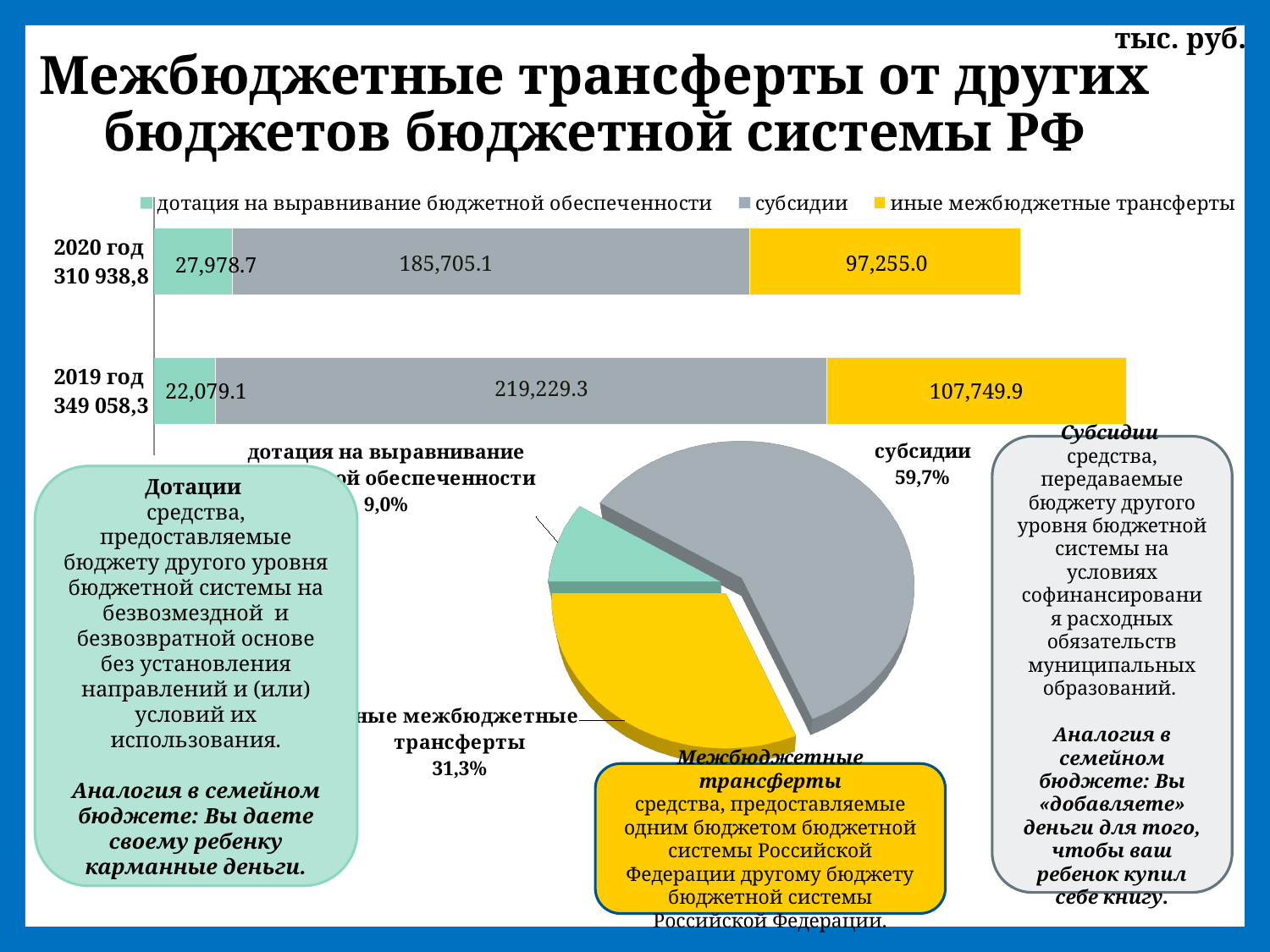
In the stacked bar chart, what is the value of дотация на выравнивание бюджетной обеспеченности for 2020 год? 27,978.7 How many years (categories) are shown in the stacked bar chart? 2 In the pie chart, which slice is the smallest? дотация на выравнивание бюджетной обеспеченности How many series does the legend of the stacked bar chart list? 3 In the stacked bar chart, which year has the larger value for иные межбюджетные трансферты, 2020 год or 2019 год? 2019 год What kind of chart is the upper chart on the slide? Bar chart In the stacked bar chart, by how much do субсидии in 2019 год exceed субсидии in 2020 год? 33,524.2 In the pie chart, what share do субсидии have? 59,7% In the stacked bar chart, what is the difference between дотация на выравнивание бюджетной обеспеченности in 2020 год and in 2019 год? 5,899.6 In the stacked bar chart, what is the value of субсидии for 2020 год? 185,705.1 In the stacked bar chart, what is the value of иные межбюджетные трансферты for 2019 год? 107,749.9 In the stacked bar chart, what is the total of the 2020 год bar as printed on the slide? 310 938,8